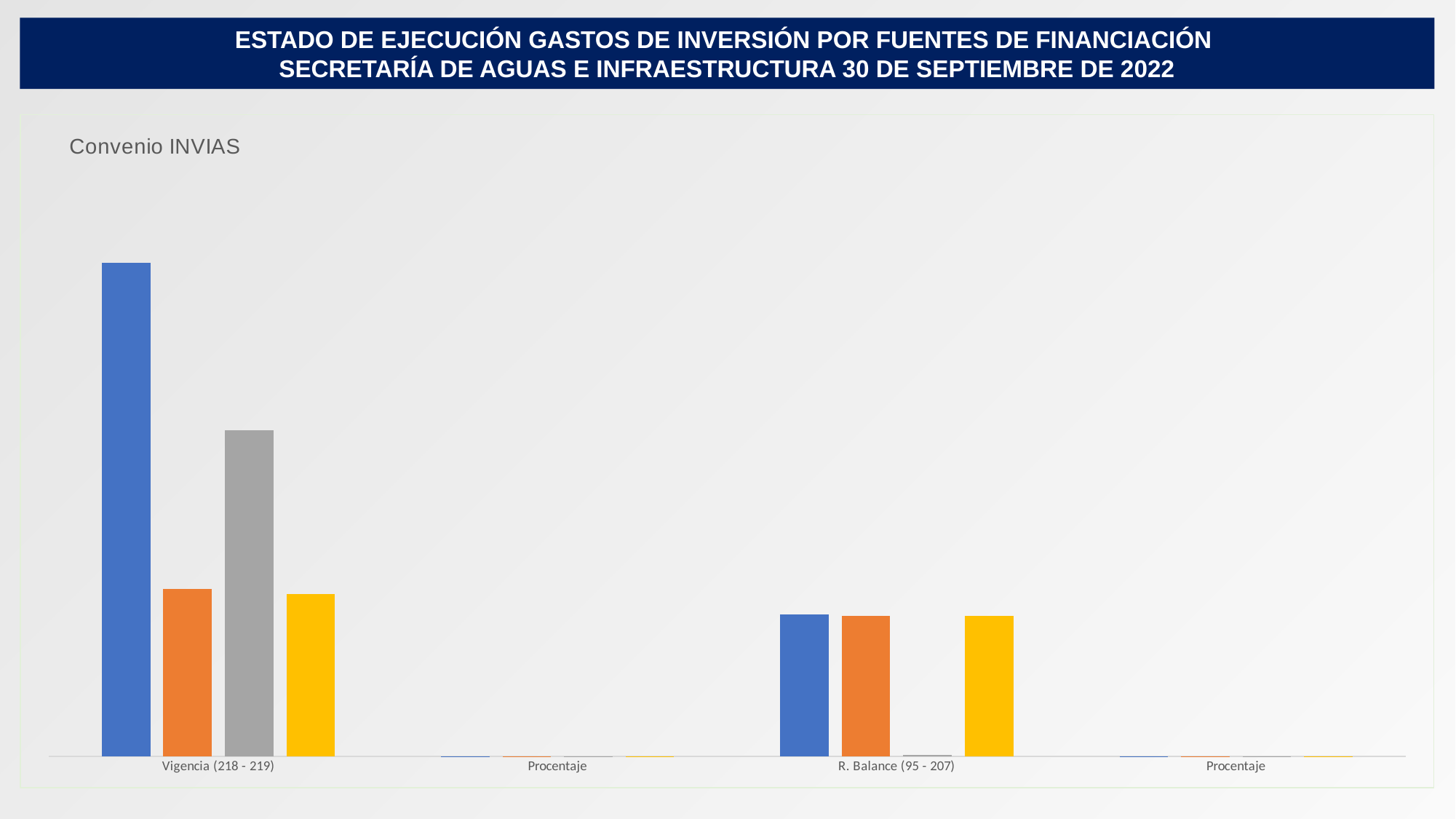
Which category has the tallest bar in the chart? Vigencia (218 - 219) What is the title of the chart? Convenio INVIAS How many categories are shown along the x axis of the chart? 4 In the Vigencia (218 - 219) category, which coloured bar is the shortest? yellow Is the blue bar for Vigencia (218 - 219) taller or shorter than the blue bar for R. Balance (95 - 207)? taller What is the label of the first category on the x axis? Vigencia (218 - 219) Is the gray bar for Vigencia (218 - 219) taller or shorter than the orange bar in the same category? taller Is the gray bar for R. Balance (95 - 207) taller or shorter than the gray bar for Vigencia (218 - 219)? shorter Which category label appears twice on the x axis? Procentaje What kind of chart is shown on the slide? bar chart In the Vigencia (218 - 219) category, which coloured bar is the tallest? blue